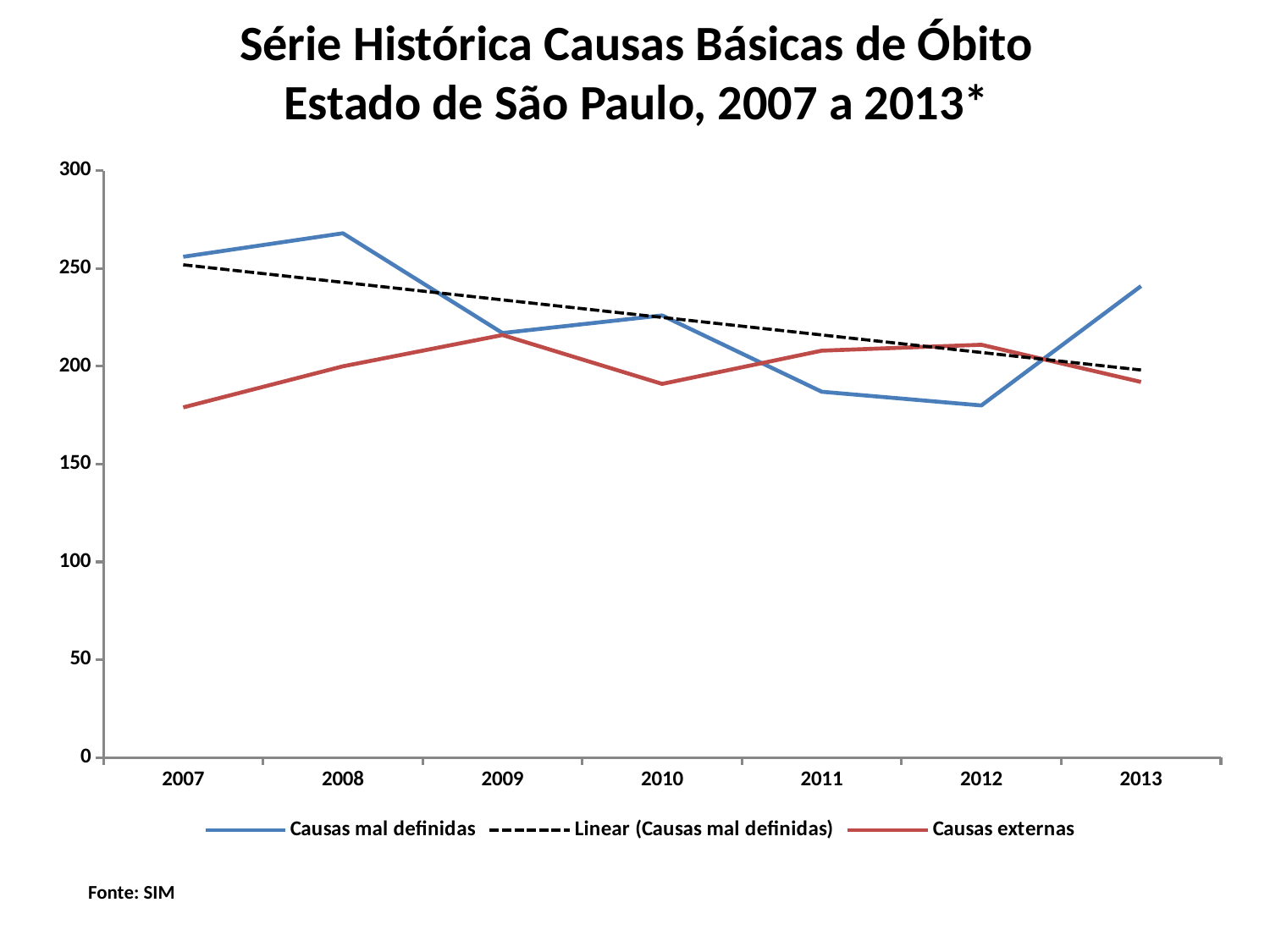
In which year is the value for Causas mal definidas highest? 2008 Does the dashed Linear (Causas mal definidas) trend line rise or fall from 2007 to 2013? fall Is the value for Causas mal definidas in 2012 greater or less than 200? less In which year is the value for Causas externas lowest? 2007 How many years are plotted along the x axis? 7 In 2012, which series has the larger value, Causas mal definidas or Causas externas? Causas externas What source is cited below the chart? Fonte: SIM Is the value for Causas externas in 2007 greater or less than 200? less What kind of chart is shown on the slide? line chart How many series does the legend list? 3 Is the value for Causas mal definidas in 2013 greater or less than 200? greater